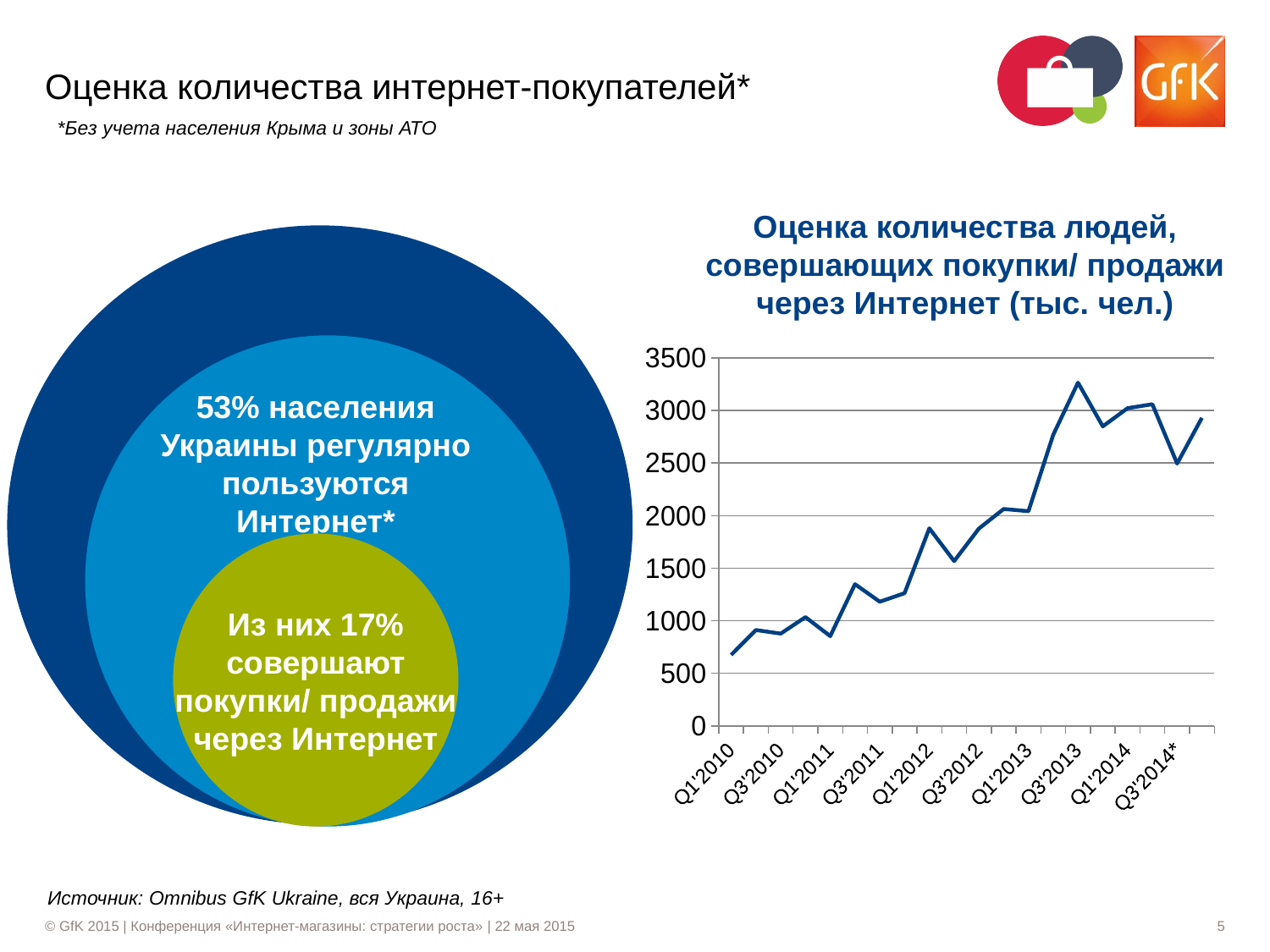
Is the value for Q3'2013 greater or less than 3000? greater How many quarter labels are shown on the x axis of the chart? 10 Which quarter has the highest value on the chart? Q3'2013 What kind of chart is shown on the right side of the slide? line chart Is the value for Q3'2011 greater or less than 1000? greater What is the highest value shown on the y axis of the chart? 3500 Is the value for Q1'2010 greater or less than 1000? less Which quarter has the lowest value on the chart? Q1'2010 What is the title of the chart on the slide? Оценка количества людей, совершающих покупки/ продажи через Интернет (тыс. чел.) Overall, do the values on the chart rise or fall from Q1'2010 to Q3'2014*? rise Which is larger, the value for Q1'2010 or the value for Q3'2013? Q3'2013